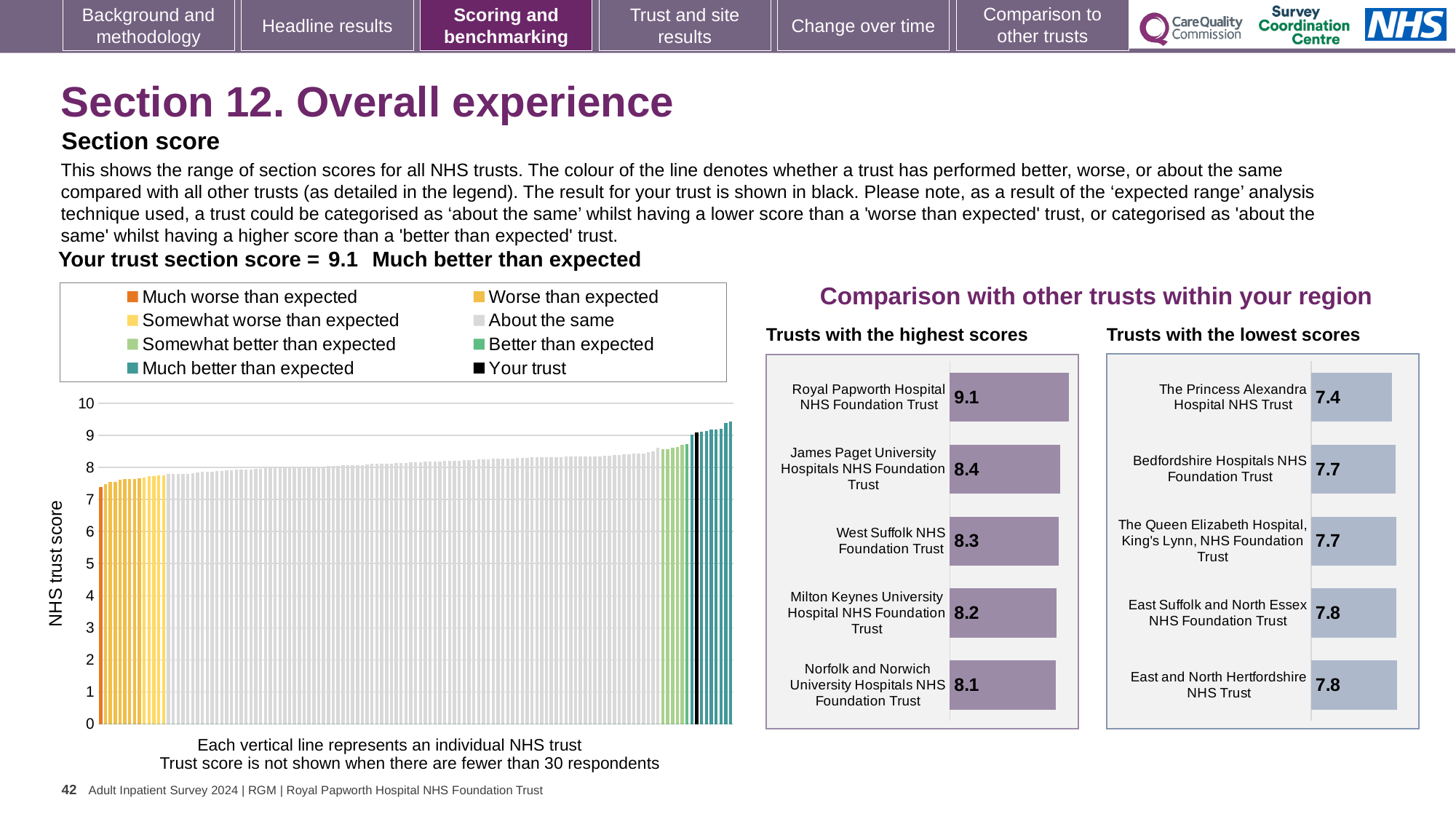
How many trusts are shown in the 'Trusts with the lowest scores' chart? 5 In the 'Trusts with the highest scores' chart, what is the difference between the scores of Royal Papworth Hospital NHS Foundation Trust and James Paget University Hospitals NHS Foundation Trust? 0.7 In the 'Trusts with the highest scores' chart, which trust has the lowest score shown? Norfolk and Norwich University Hospitals NHS Foundation Trust What kind of chart is the 'Trusts with the highest scores' chart? Bar chart In the 'Trusts with the lowest scores' chart, what is the difference between the scores of East and North Hertfordshire NHS Trust and The Princess Alexandra Hospital NHS Trust? 0.4 In the 'Trusts with the highest scores' chart, what is the score for Royal Papworth Hospital NHS Foundation Trust? 9.1 In the 'Trusts with the lowest scores' chart, which trust has the lowest score? The Princess Alexandra Hospital NHS Trust In the 'Trusts with the lowest scores' chart, what is the score for The Princess Alexandra Hospital NHS Trust? 7.4 In the large chart on the left showing all NHS trusts, what is the label of the y axis? NHS trust score In the 'Trusts with the highest scores' chart, which has a higher score: Milton Keynes University Hospital NHS Foundation Trust or West Suffolk NHS Foundation Trust? West Suffolk NHS Foundation Trust In the 'Trusts with the lowest scores' chart, what is the score for East Suffolk and North Essex NHS Foundation Trust? 7.8 In the 'Trusts with the highest scores' chart, what is the score for West Suffolk NHS Foundation Trust? 8.3